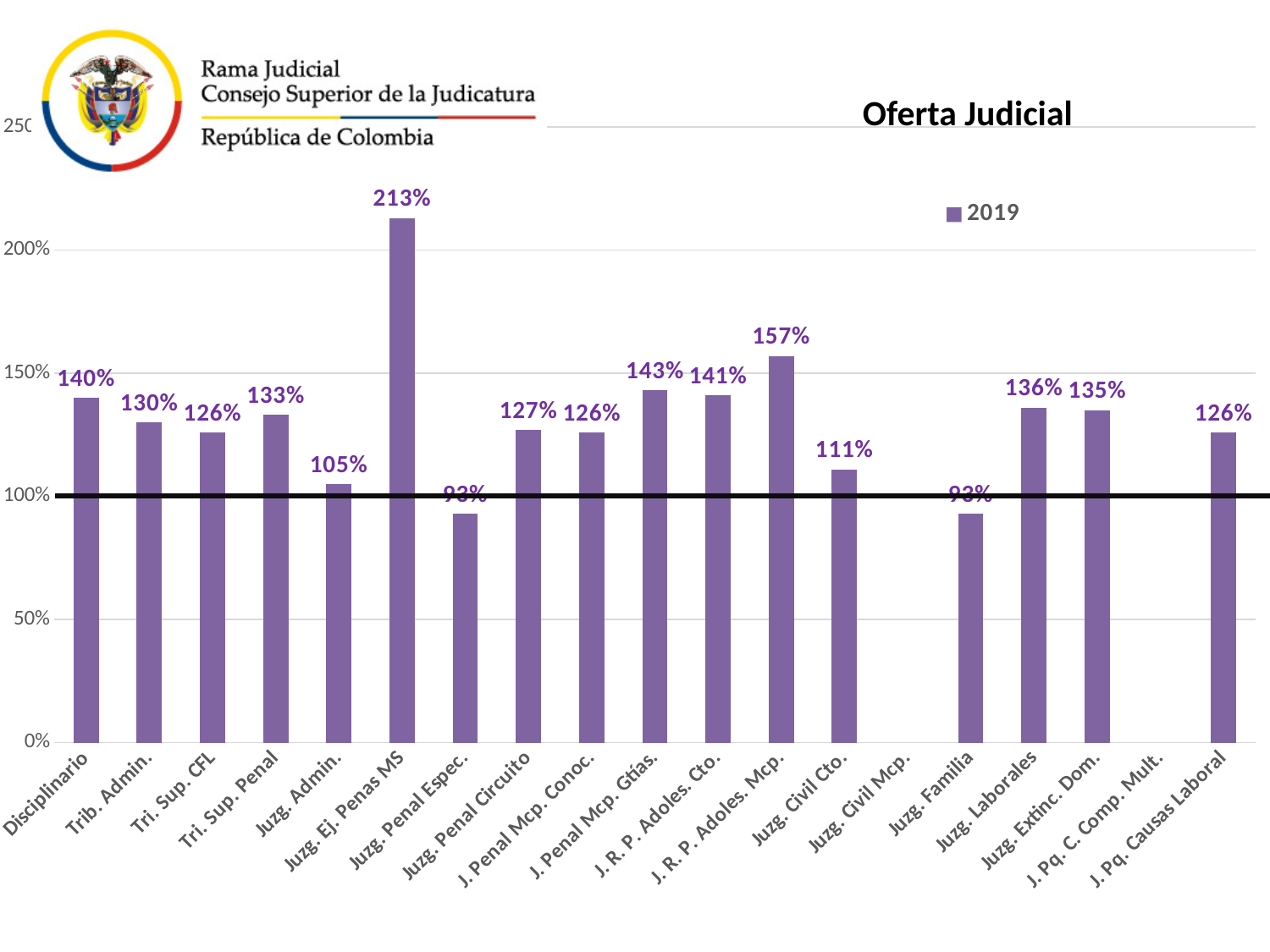
Is the value for Juzg. Familia greater or less than 100%? less Is the value for Juzg. Penal Espec. greater or less than 100%? less Which is larger, the value for Trib. Admin. or the value for Tri. Sup. Penal? Tri. Sup. Penal What is the title of the chart? Oferta Judicial Which category has the highest value? Juzg. Ej. Penas MS What is the difference between the values for Juzg. Ej. Penas MS and Disciplinario? 73% How many series does the legend list? 1 What is the value for Juzg. Civil Cto.? 111% What is the value for J. R. P. Adoles. Mcp.? 157% What kind of chart is shown on the slide? Bar chart How many categories are labelled on the x axis? 19 What is the value for Disciplinario? 140%